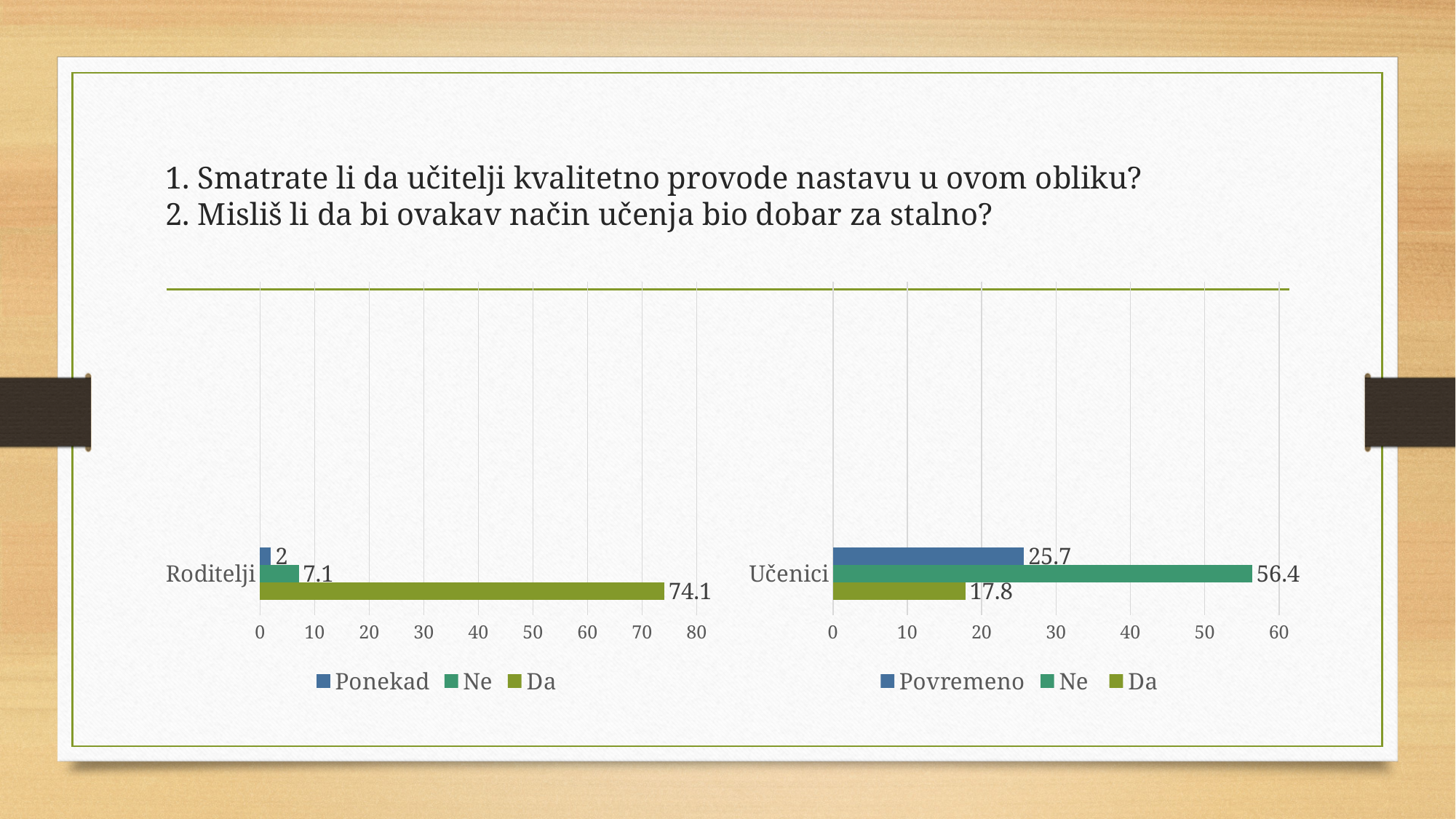
In the left chart (Roditelji), which series has the lowest value? Ponekad In the right chart (Učenici), which is larger, Povremeno or Da? Povremeno In the left chart (Roditelji), what is the difference between the values for Da and Ne? 67 In the left chart (Roditelji), what is the value for Da? 74.1 In the right chart (Učenici), what is the value for Povremeno? 25.7 In the right chart (Učenici), which series has the highest value? Ne What kind of chart is the left chart (Roditelji)? Bar chart In the right chart (Učenici), what is the difference between the values for Ne and Da? 38.6 In the right chart (Učenici), what is the value for Ne? 56.4 How many series does the legend of the right chart (Učenici) list? 3 In the left chart (Roditelji), what is the value for Ne? 7.1 In the left chart (Roditelji), what is the value for Ponekad? 2